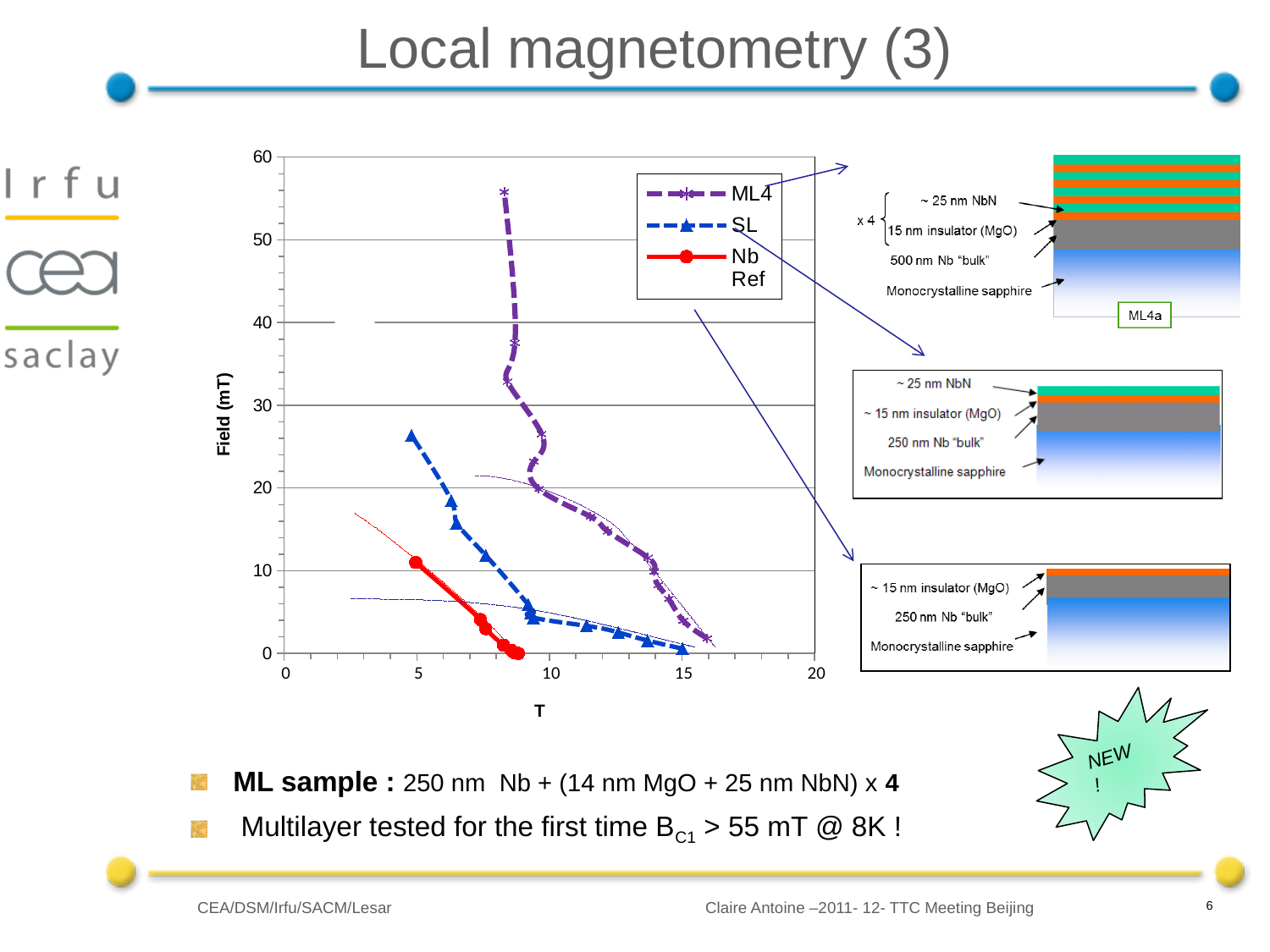
Is the highest field value reached by the ML4 series greater or less than 50 mT? greater Which series has the lowest maximum field value on the chart? Nb Ref What kind of chart is shown on the slide? line chart What are the three series named in the chart legend? ML4, SL, Nb Ref What is the highest value shown on the vertical axis of the chart? 60 How many series does the chart legend list? 3 What is the title of the vertical axis of the chart? Field (mT) Is the highest field value reached by the Nb Ref series greater or less than 20 mT? less Which series reaches a higher field, SL or Nb Ref? SL Is the highest field value reached by the SL series greater or less than 20 mT? greater Which series reaches the highest field value on the chart? ML4 Does the field for the SL series rise or fall as T increases? fall